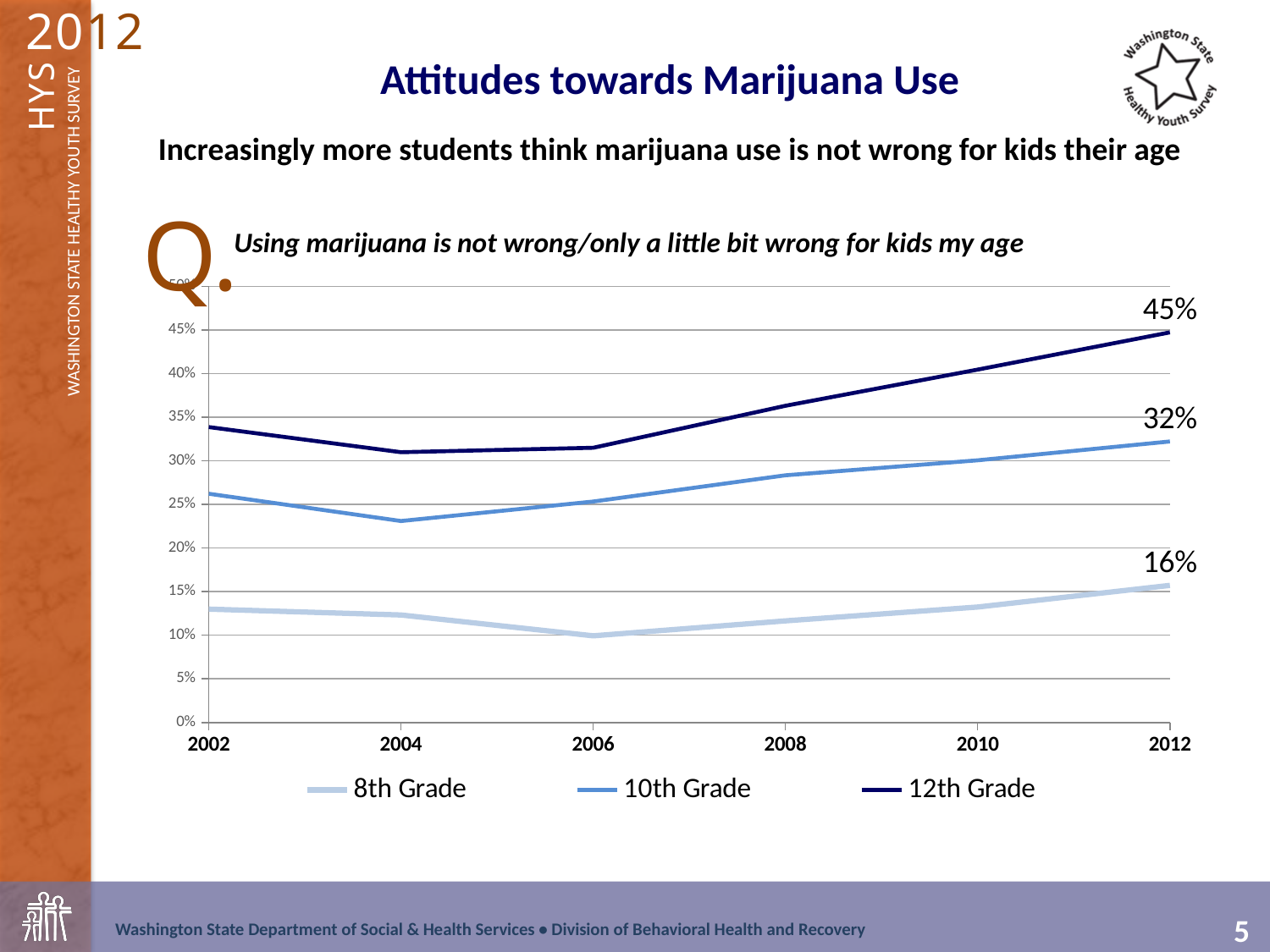
Which grade has the lowest value in 2012? 8th Grade How many series does the legend list? 3 Which grade has the highest value in 2012? 12th Grade What is the value for 8th Grade in 2012? 16% Is the value for 8th Grade in 2006 greater or less than 15%? less What kind of chart is shown on the slide? Line chart What is the difference between the 12th Grade and 8th Grade values in 2012? 29 percentage points Does the 12th Grade line rise or fall from 2006 to 2012? Rise What is the value for 10th Grade in 2012? 32% Is the value for 12th Grade in 2002 greater or less than 30%? greater What is the value for 12th Grade in 2012? 45% Is the value for 10th Grade in 2004 greater or less than 25%? less